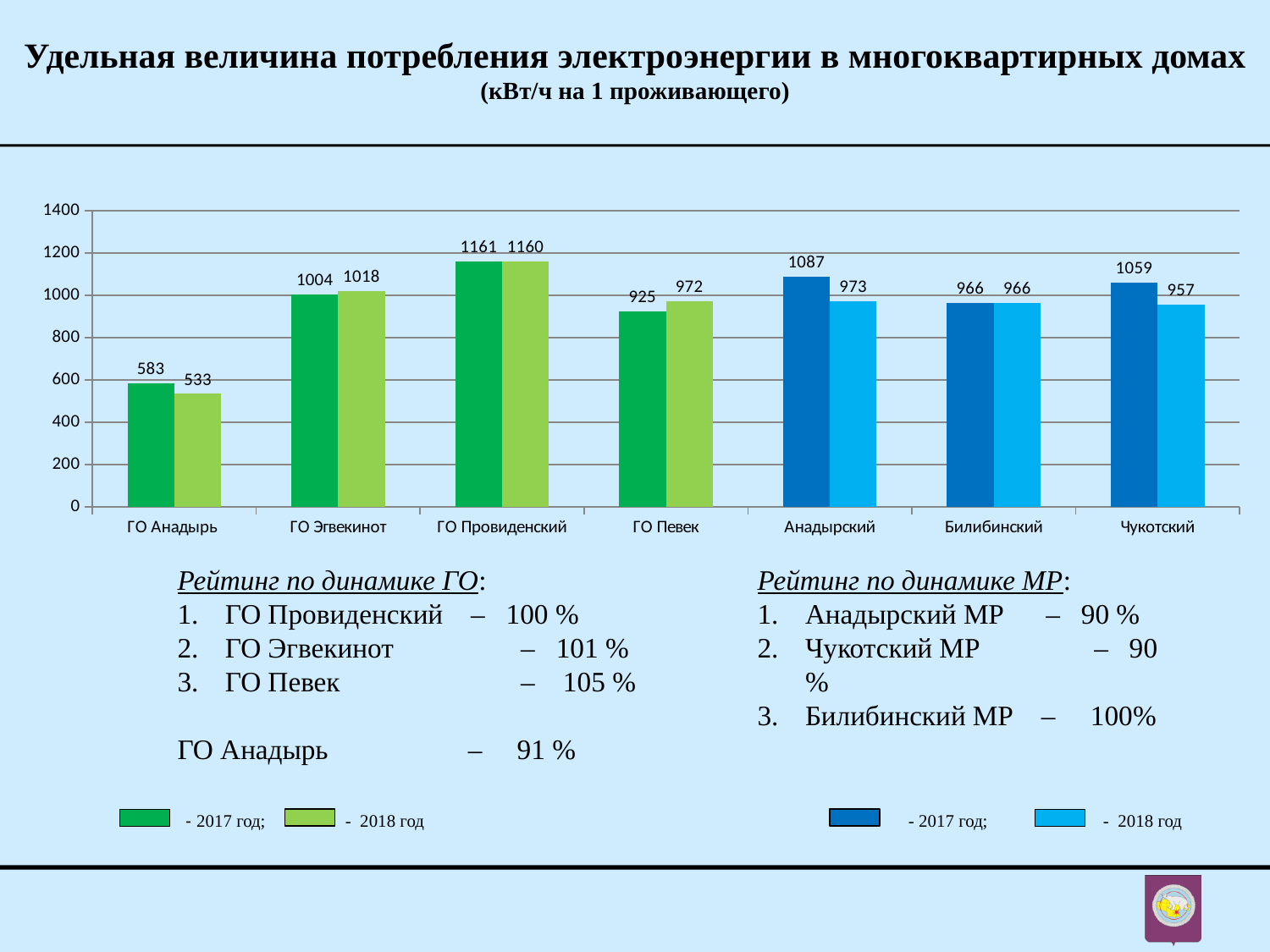
What is the 2018 value for ГО Певек? 972 What is the 2017 value for ГО Анадырь? 583 What is the 2018 value for Чукотский? 957 Which category has the lowest 2018 value? ГО Анадырь How many categories (municipalities) are shown on the x axis of the chart? 7 What type of chart is shown on the slide? bar chart Is the 2017 value for ГО Анадырь greater or less than 600? less What is the difference between the 2017 and 2018 values for Анадырский? 114 Which is larger: the 2018 value for ГО Эгвекинот or the 2018 value for ГО Певек? ГО Эгвекинот According to the legend, which two years are compared in the chart? 2017 год and 2018 год Which category has the highest 2017 value? ГО Провиденский What is the 2017 value for Анадырский? 1087